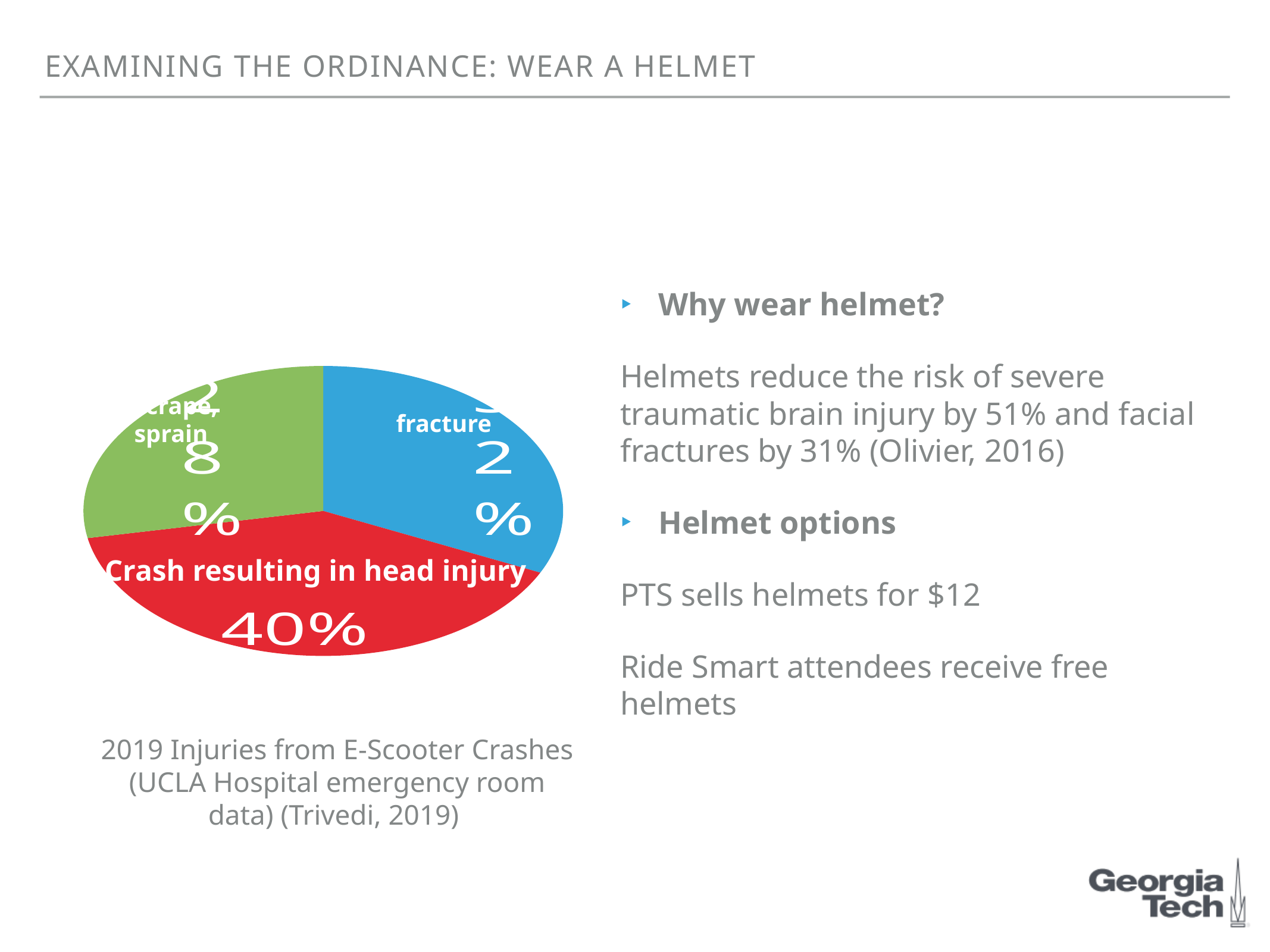
What kind of chart is shown on the slide? pie chart What colour is the 'Crash resulting in head injury' slice of the pie chart? red Which is larger in the pie chart: 'Crash resulting in head injury' or 'scrape, sprain'? Crash resulting in head injury Which is larger in the pie chart: 'Crash resulting in head injury' or 'fracture'? Crash resulting in head injury What is the caption below the pie chart? 2019 Injuries from E-Scooter Crashes (UCLA Hospital emergency room data) (Trivedi, 2019) How many slices does the pie chart have? 3 What percentage of the pie chart is labelled 'Crash resulting in head injury'? 40% Which slice of the pie chart is the largest? Crash resulting in head injury What share of the pie does the 'Crash resulting in head injury' slice represent? 40%